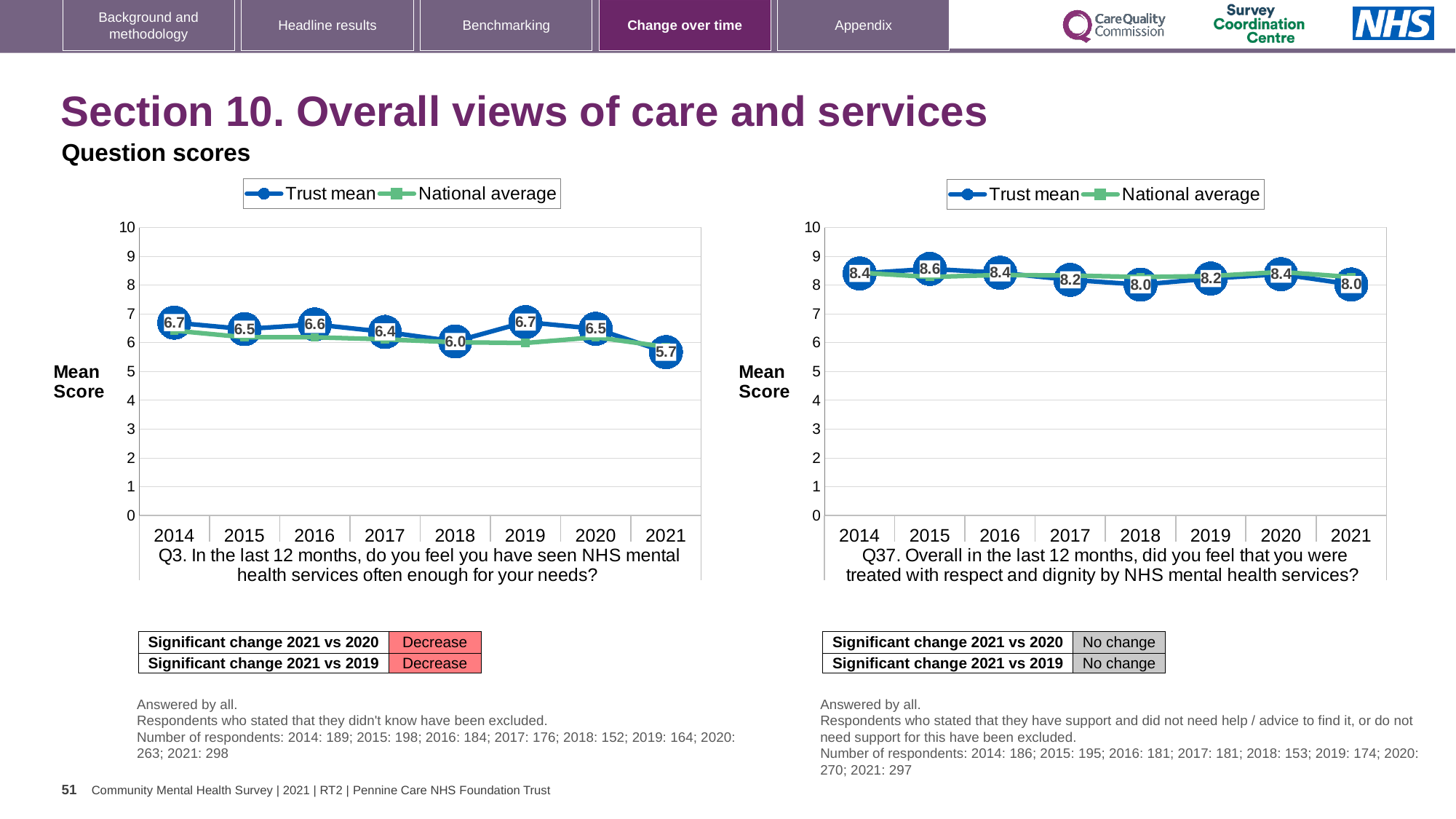
On the Q37 chart (right), which year has the highest Trust mean score? 2015 On the Q3 chart (left), what is the Trust mean score for 2021? 5.7 On the Q37 chart (right), is the Trust mean score for 2021 greater or less than 9? less What type of chart is used for the Q3 question scores (left)? Line chart On the Q3 chart (left), does the Trust mean score rise or fall from 2020 to 2021? Fall On the Q3 chart (left), which year has the lowest Trust mean score? 2021 On the Q37 chart (right), what is the Trust mean score for 2015? 8.6 On the Q3 chart (left), what is the difference between the Trust mean scores for 2020 and 2021? 0.8 On the Q3 chart (left), is the Trust mean score higher in 2019 or in 2018? 2019 On the Q37 chart (right), what is the difference between the Trust mean scores for 2015 and 2018? 0.6 How many years are plotted on the Q3 chart (left)? 8 How many series does the legend of the Q37 chart (right) list? 2